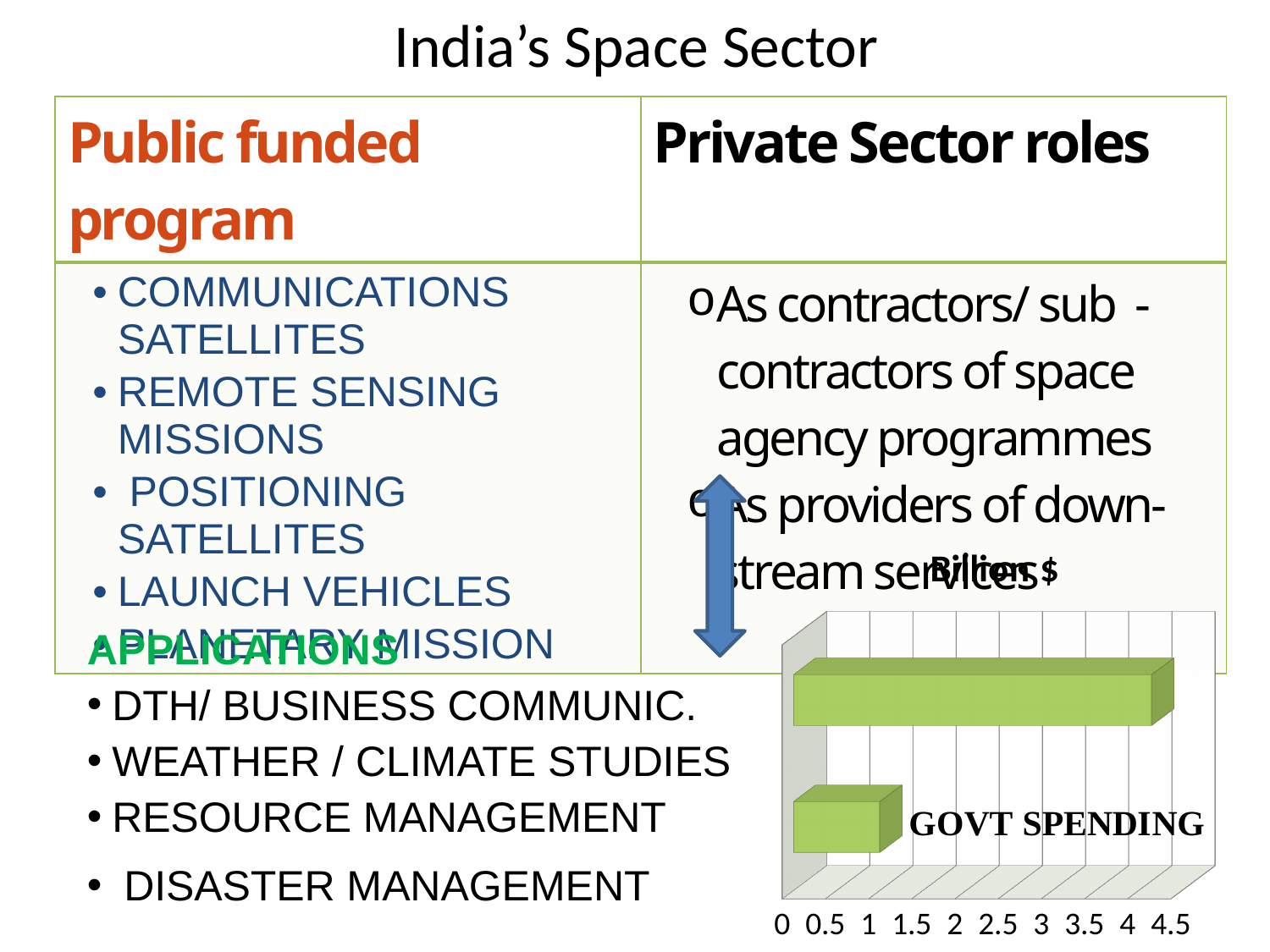
In the bar chart, is the value for GOVT SPENDING greater or less than 3? less What kind of chart is shown at the bottom right of the slide? bar chart What unit is given in the title of the bar chart? Billion $ In the bar chart, is the GOVT SPENDING bar the shorter or the longer of the two bars? shorter In the bar chart, is the value for GOVT SPENDING greater or less than 0.5? greater How many bars does the chart at the bottom right of the slide show? 2 In the bar chart, is the value for GOVT SPENDING greater or less than 2? less What is the highest tick value shown on the horizontal axis of the bar chart? 4.5